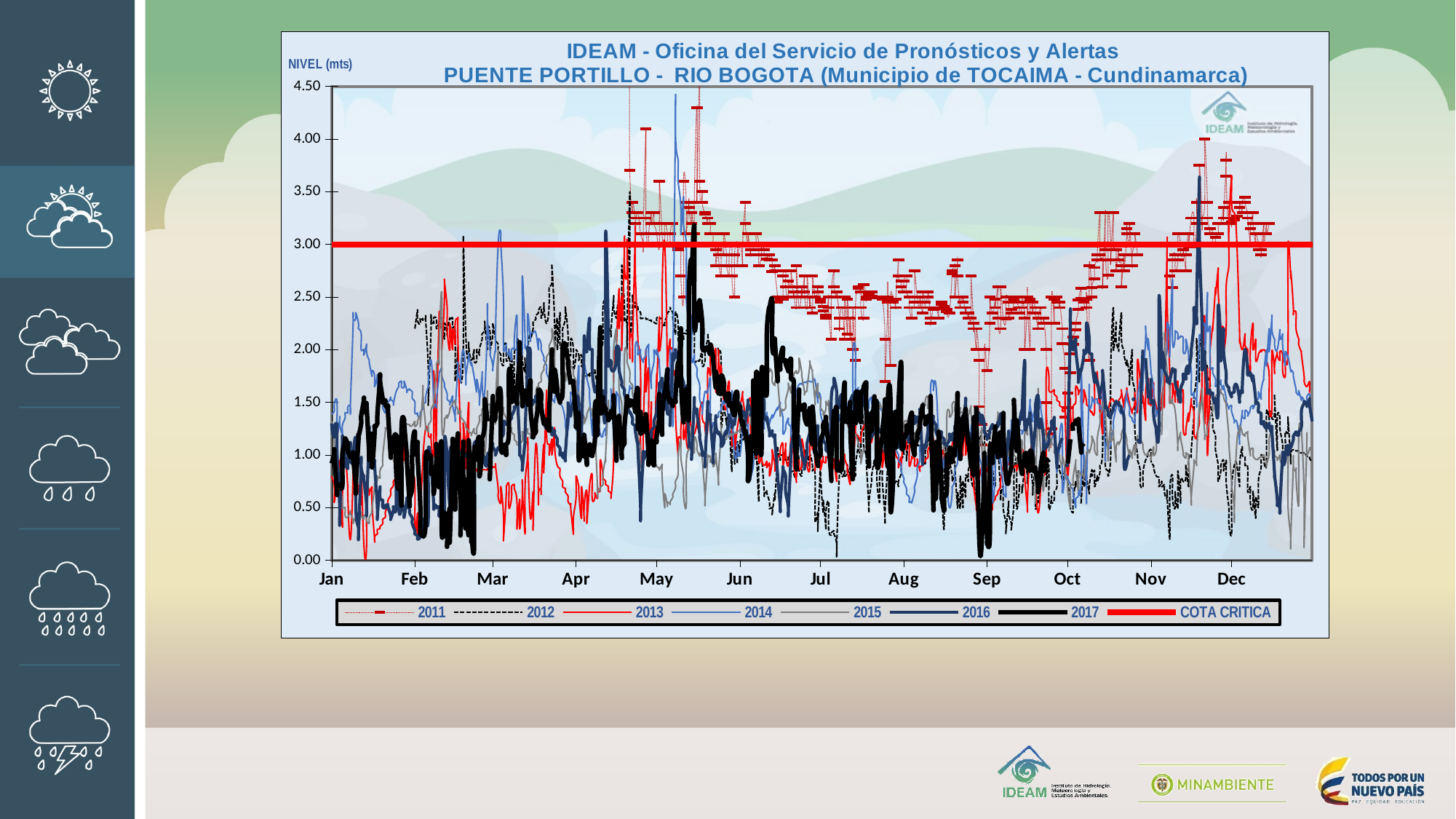
How many series does the legend list? 8 What kind of chart is shown on the slide? line chart What is the label of the y axis? NIVEL (mts) How many months are labelled along the x axis? 12 Which series is drawn as a thick solid red horizontal line? COTA CRITICA What is the highest value shown on the y axis? 4.50 Is the value for the 2015 series in mid-July greater or less than 2.50? less Is the value for the 2011 series in early June greater or less than 2.50? greater At what level (mts) is the COTA CRITICA line drawn? 3.00